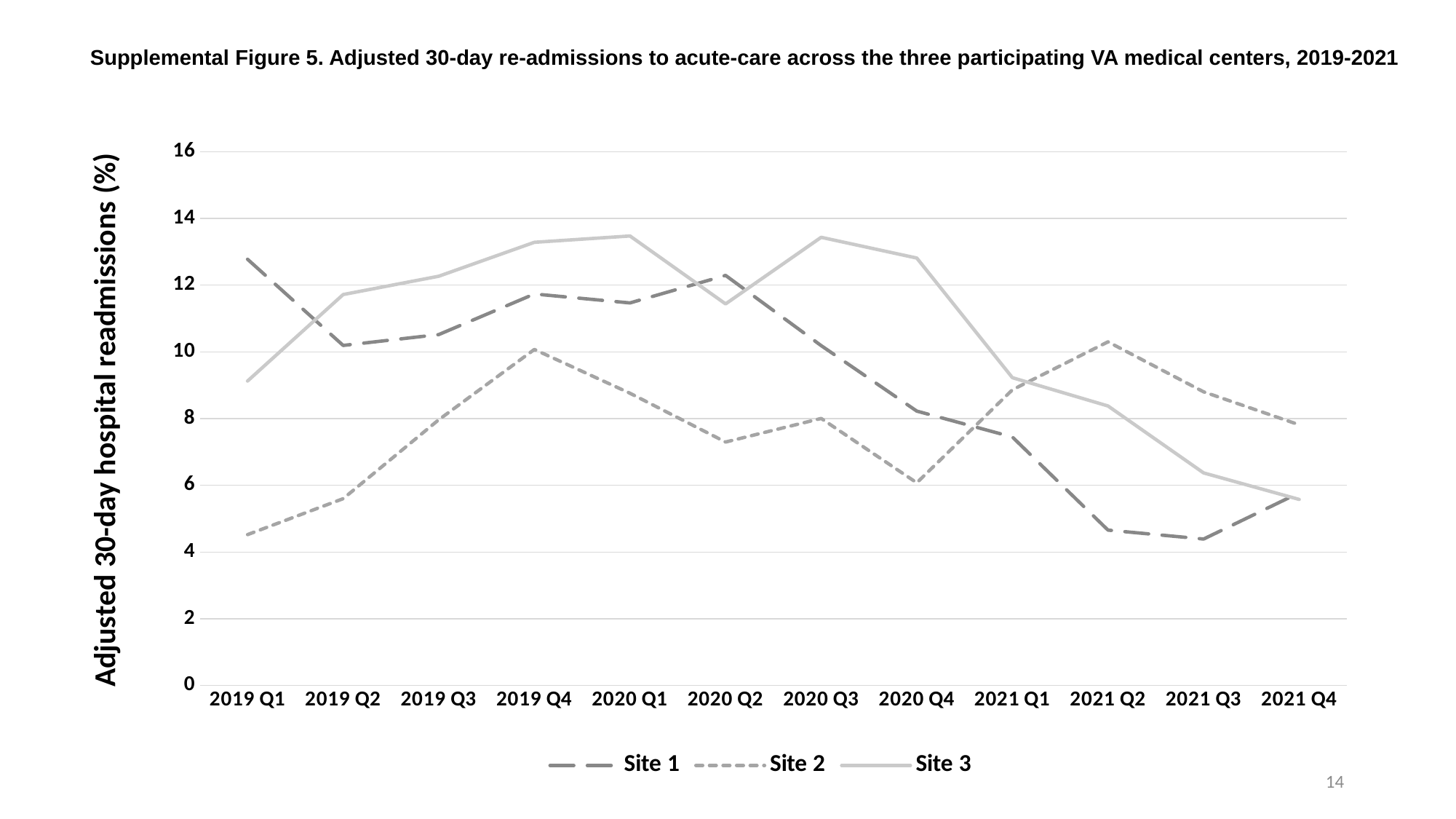
How many series does the legend list? 3 In 2021 Q2, which is larger: the value for Site 2 or the value for Site 1? Site 2 Is the value for Site 3 in 2020 Q1 greater or less than 12? greater Which site has the highest value in 2020 Q3? Site 3 In 2019 Q4, which is larger: the value for Site 3 or the value for Site 2? Site 3 What kind of chart is shown on the slide? line chart Is the value for Site 1 in 2021 Q3 greater or less than 6? less Is the value for Site 1 in 2019 Q1 greater or less than 12? greater How many quarters are shown along the x axis? 12 Does the Site 1 line rise or fall from 2020 Q2 to 2021 Q3? fall Which site has the lowest value in 2021 Q3? Site 1